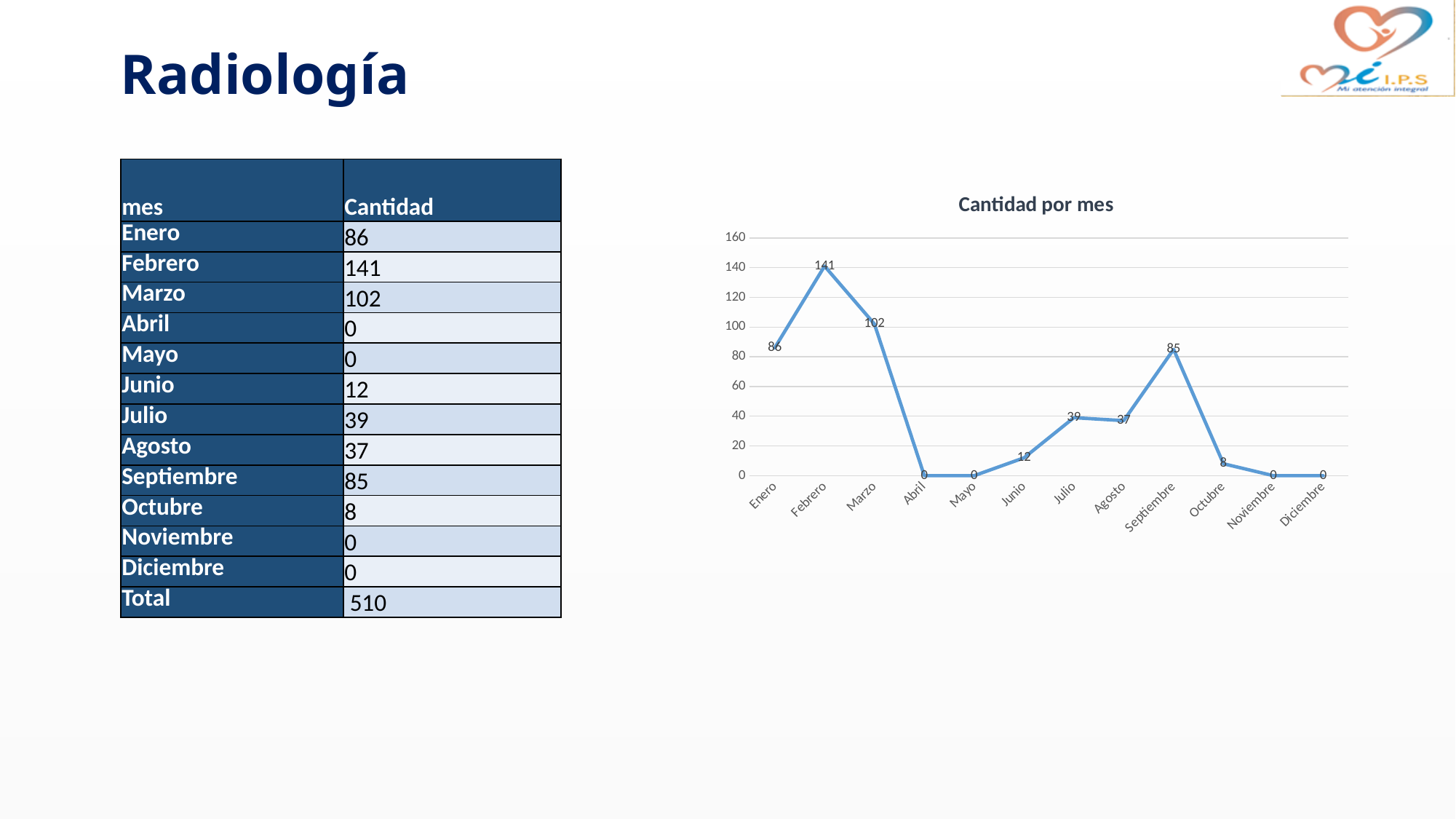
Do the values rise or fall from Septiembre to Octubre? fall What kind of chart is shown on the slide? line chart Which is larger, the value for Enero or the value for Septiembre? Enero What is the value for Febrero in the chart? 141 Is the value for Marzo greater or less than 100? greater What is the value for Junio in the chart? 12 What is the difference between the values for Julio and Agosto? 2 What is the value for Septiembre in the chart? 85 How many months are plotted on the x axis of the chart? 12 What is the difference between the values for Febrero and Marzo? 39 Which month has the highest value in the chart? Febrero What is the title of the chart? Cantidad por mes